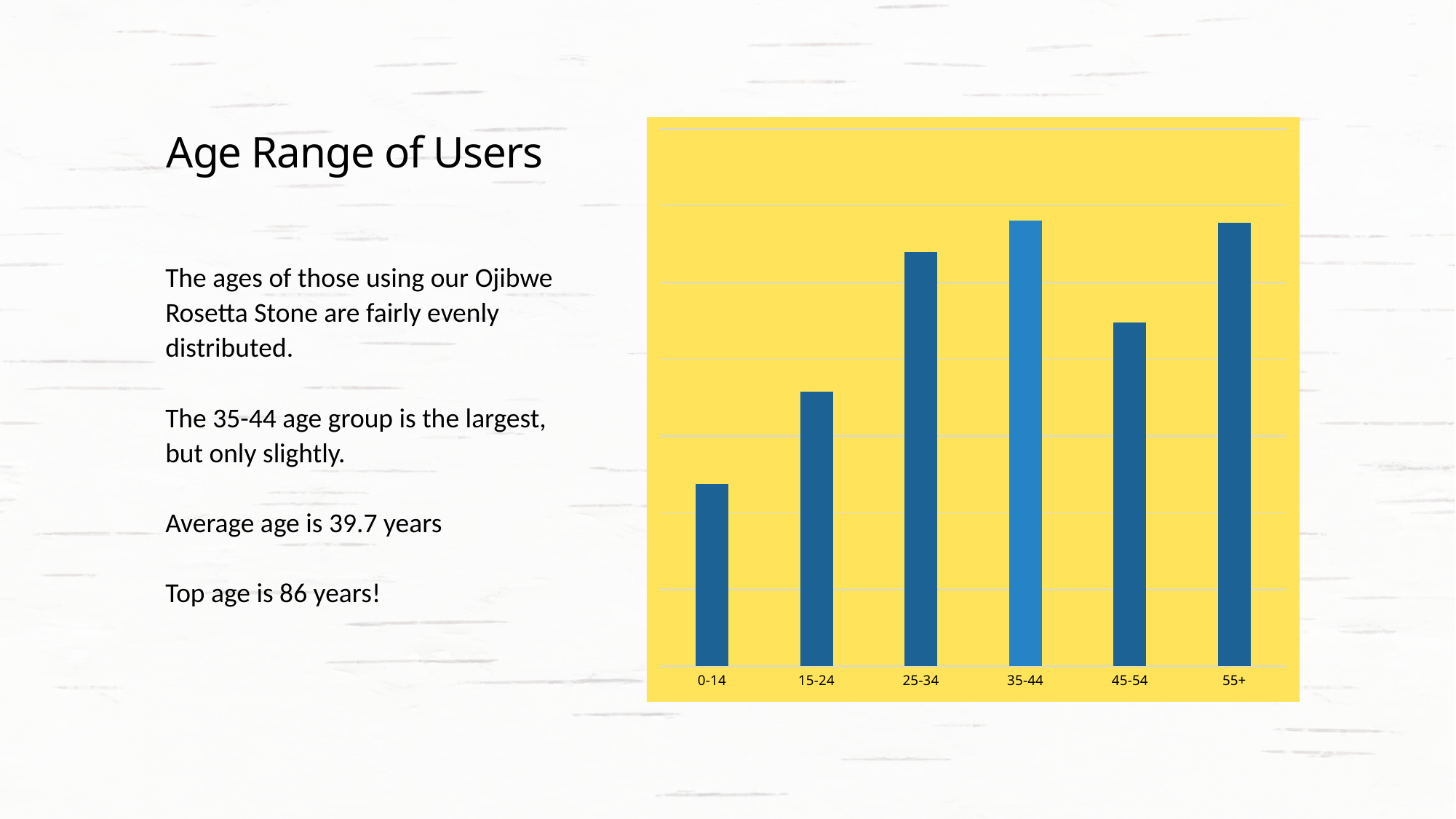
Which age group has the lowest bar in the chart? 0-14 Which bar is taller, 25-34 or 45-54? 25-34 What is the title of the slide containing the chart? Age Range of Users Do the bars rise or fall from 0-14 through 35-44? rise Which bar is taller, 15-24 or 45-54? 45-54 Which bar is taller, 0-14 or 45-54? 45-54 How many age groups are shown on the x axis of the chart? 6 Which age group's bar is drawn in a lighter shade of blue than the others? 35-44 What kind of chart is shown on the slide? bar chart Which age group has the highest bar in the chart? 35-44